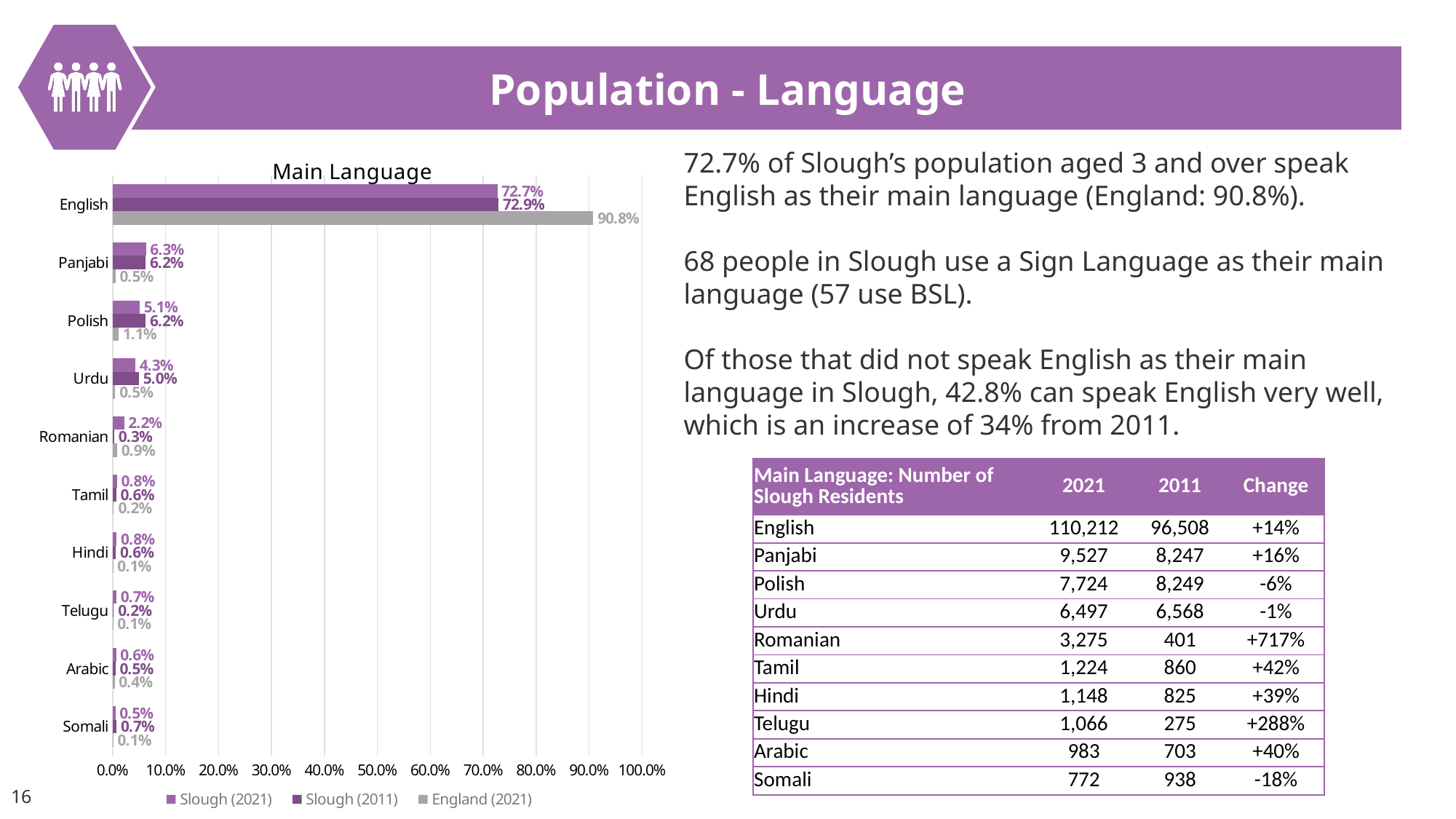
In the Main Language chart, which language has the highest Slough (2021) value? English In the Main Language chart, what is the value for English in the Slough (2021) series? 72.7% In the Main Language chart, what is the England (2021) value for Polish? 1.1% In the Main Language chart, what is the Slough (2011) value for Romanian? 0.3% How many series does the legend of the Main Language chart list? 3 What kind of chart is the Main Language chart? Bar chart In the Main Language chart, which language has the lowest Slough (2021) value? Somali What are the three series listed in the legend of the Main Language chart? Slough (2021), Slough (2011), England (2021) In the Main Language chart, is the England (2021) value for English greater or less than 90.0%? greater In the Main Language chart, what is the difference between the England (2021) and Slough (2021) values for English? 18.1% How many languages are shown on the Main Language chart? 10 In the Main Language chart, which is larger for Polish: the Slough (2021) value or the Slough (2011) value? Slough (2011)